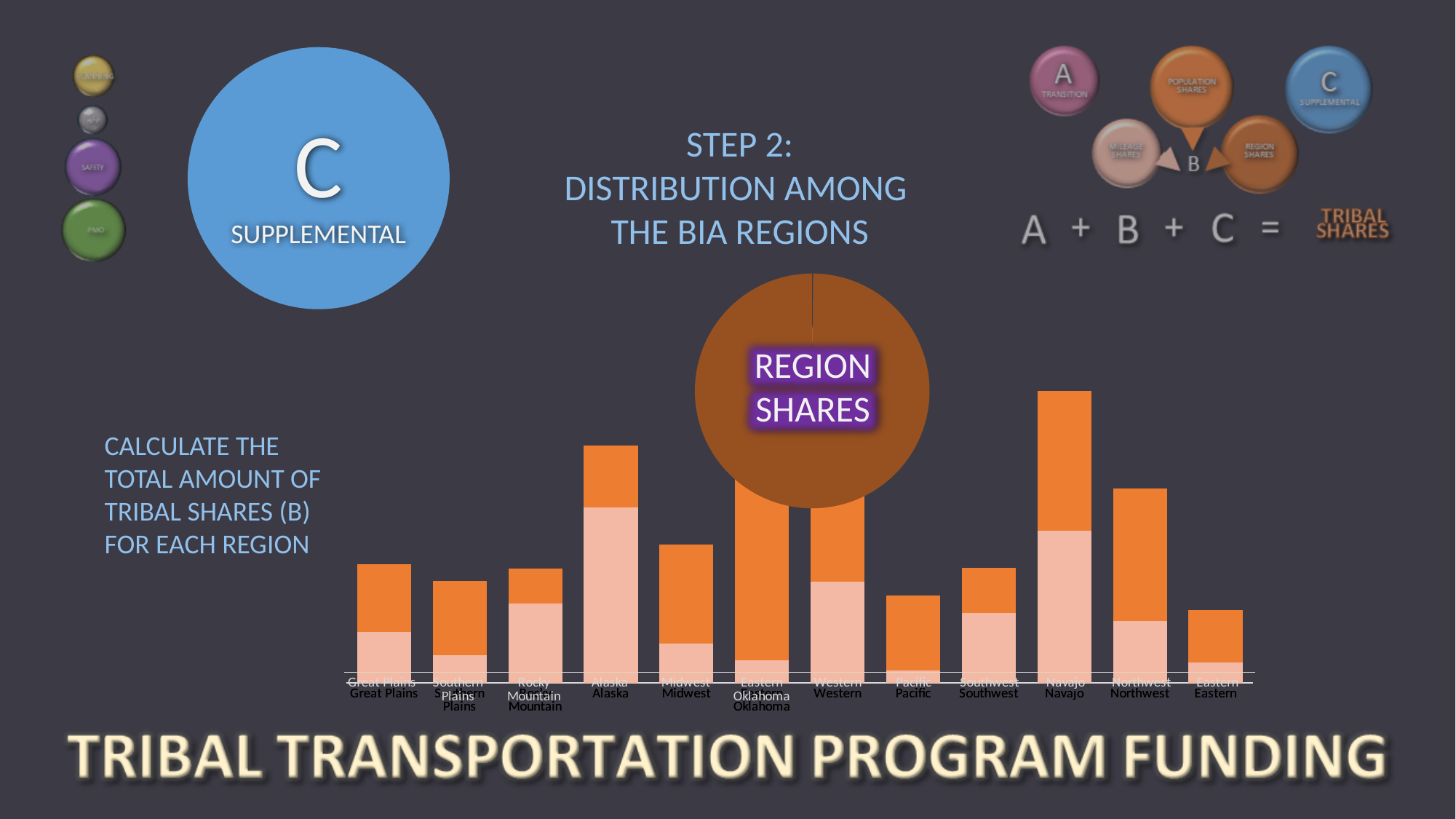
Which bar is taller, Rocky Mountain or Alaska? Alaska Which region's bar is the first category on the left of the x axis? Great Plains What label is shown in the circle overlaying the top of the bar chart? REGION SHARES Which bar is taller, Alaska or Navajo? Navajo Which bar is taller, Southwest or Northwest? Northwest What kind of chart is shown on the slide? stacked bar chart How many regions (categories) are shown along the x axis of the bar chart? 12